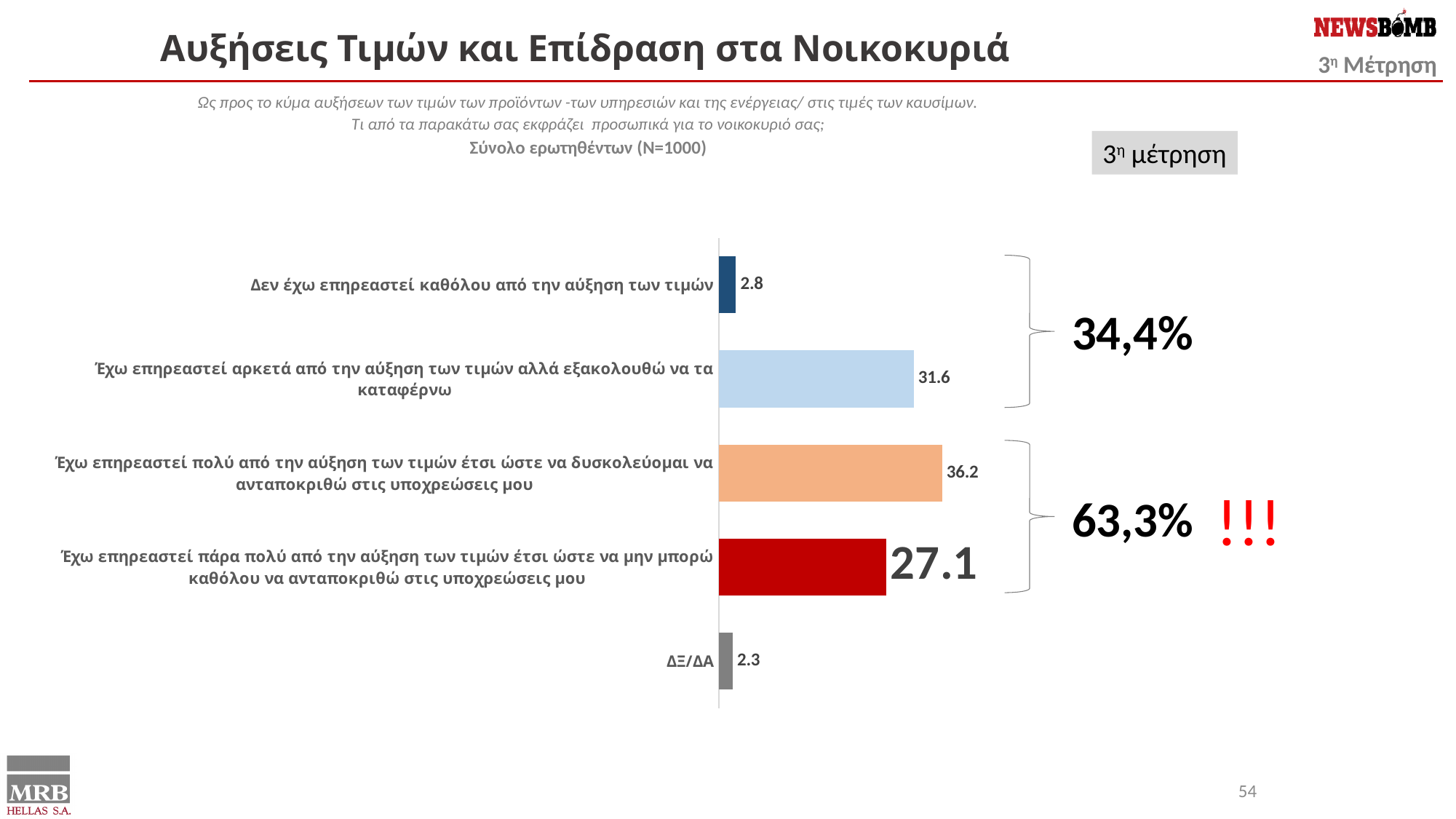
What is the value for "Δεν έχω επηρεαστεί καθόλου από την αύξηση των τιμών"? 2.8 What is the value for ΔΞ/ΔΑ? 2.3 Which category has the highest value? Έχω επηρεαστεί πολύ από την αύξηση των τιμών έτσι ώστε να δυσκολεύομαι να ανταποκριθώ στις υποχρεώσεις μου What kind of chart is shown on the slide? Bar chart What combined percentage is shown next to the bracket grouping the first two categories ("καθόλου" and "αρκετά")? 34,4% Which category has the lowest value? ΔΞ/ΔΑ What is the difference between the value for "Έχω επηρεαστεί πολύ..." (36.2) and "Έχω επηρεαστεί αρκετά..." (31.6)? 4.6 Which is larger: the value for "Έχω επηρεαστεί αρκετά..." or the value for "Έχω επηρεαστεί πάρα πολύ..."? Έχω επηρεαστεί αρκετά... What is the value for "Έχω επηρεαστεί πάρα πολύ από την αύξηση των τιμών έτσι ώστε να μην μπορώ καθόλου να ανταποκριθώ στις υποχρεώσεις μου"? 27.1 What is the value for "Έχω επηρεαστεί αρκετά από την αύξηση των τιμών αλλά εξακολουθώ να τα καταφέρνω"? 31.6 What combined percentage is shown next to the bracket grouping the two bottom-most affected categories ("πολύ" and "πάρα πολύ")? 63,3% How many categories (bars) does the chart show? 5